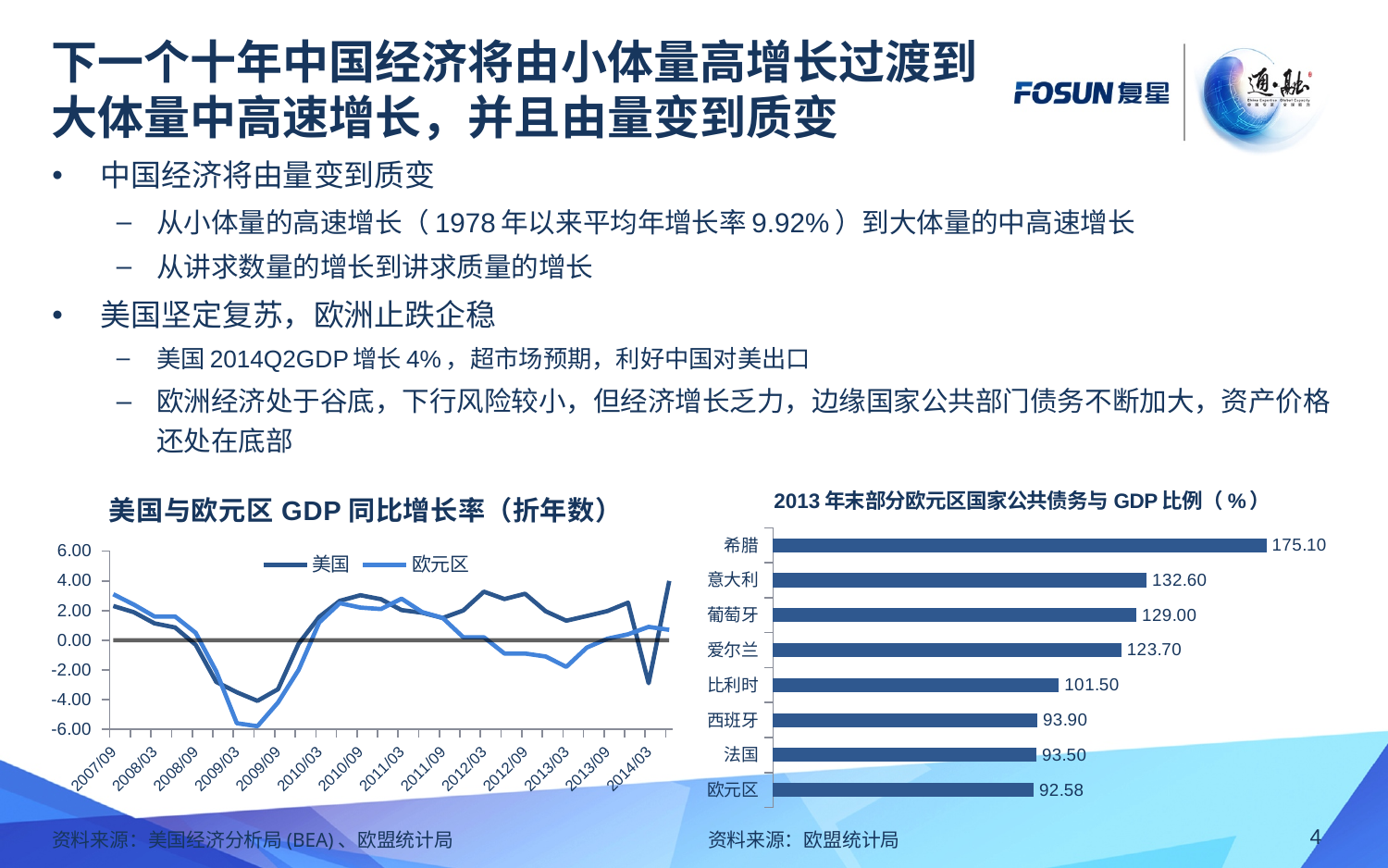
In the chart titled "2013 年末部分欧元区国家公共债务与 GDP 比例（%）", what is the value for 希腊? 175.10 In the chart titled "美国与欧元区 GDP 同比增长率（折年数）", is the value for 欧元区 at 2009/03 greater or less than -4.00? less What kind of chart is the one titled "美国与欧元区 GDP 同比增长率（折年数）"? line chart In the chart titled "2013 年末部分欧元区国家公共债务与 GDP 比例（%）", what is the difference between the values for 意大利 and 葡萄牙? 3.60 In the chart titled "美国与欧元区 GDP 同比增长率（折年数）", what are the two series named in the legend? 美国 and 欧元区 In the chart titled "2013 年末部分欧元区国家公共债务与 GDP 比例（%）", how many categories are shown? 8 In the chart titled "2013 年末部分欧元区国家公共债务与 GDP 比例（%）", which is larger, the value for 爱尔兰 or the value for 西班牙? 爱尔兰 What kind of chart is the one titled "2013 年末部分欧元区国家公共债务与 GDP 比例（%）"? bar chart How many series does the legend list in the chart titled "美国与欧元区 GDP 同比增长率（折年数）"? 2 In the chart titled "2013 年末部分欧元区国家公共债务与 GDP 比例（%）", which category has the highest value? 希腊 In the chart titled "2013 年末部分欧元区国家公共债务与 GDP 比例（%）", which category has the lowest value? 欧元区 In the chart titled "2013 年末部分欧元区国家公共债务与 GDP 比例（%）", what is the value for 比利时? 101.50